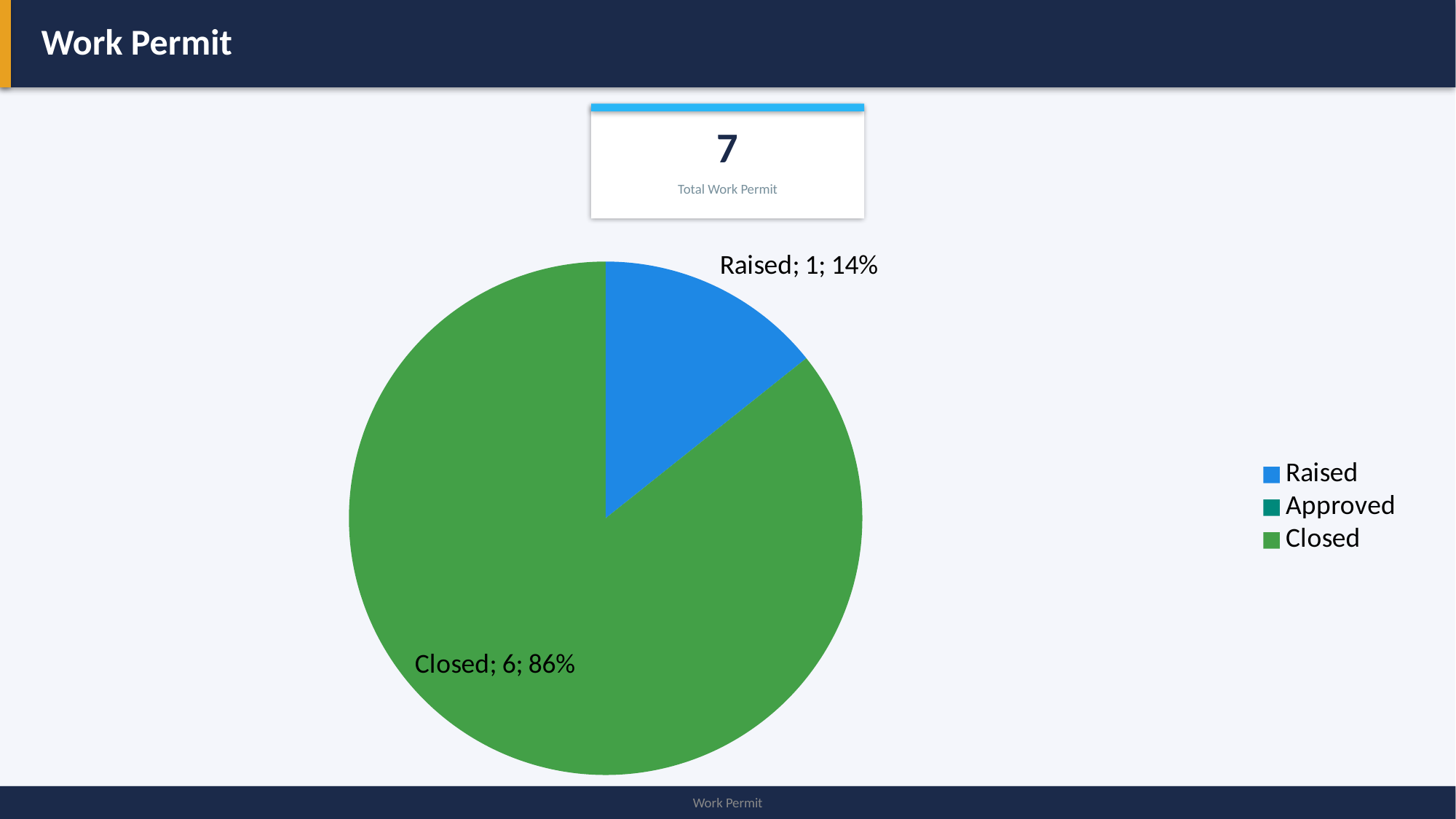
What share of the pie does the Closed slice represent? 86% What colour is the Closed slice in the pie chart? green How many work permits are Raised according to the pie chart? 1 Is the Closed count larger than the Raised count? Yes Which of the two labelled slices is smaller, Raised or Closed? Raised What is the Total Work Permit figure shown above the chart? 7 Which category has the largest slice in the pie chart? Closed What share of the pie does the Raised slice represent? 14% What kind of chart is shown on the slide? pie chart How many entries does the legend list? 3 How many work permits are Closed according to the pie chart? 6 What is the difference between the Closed count and the Raised count? 5